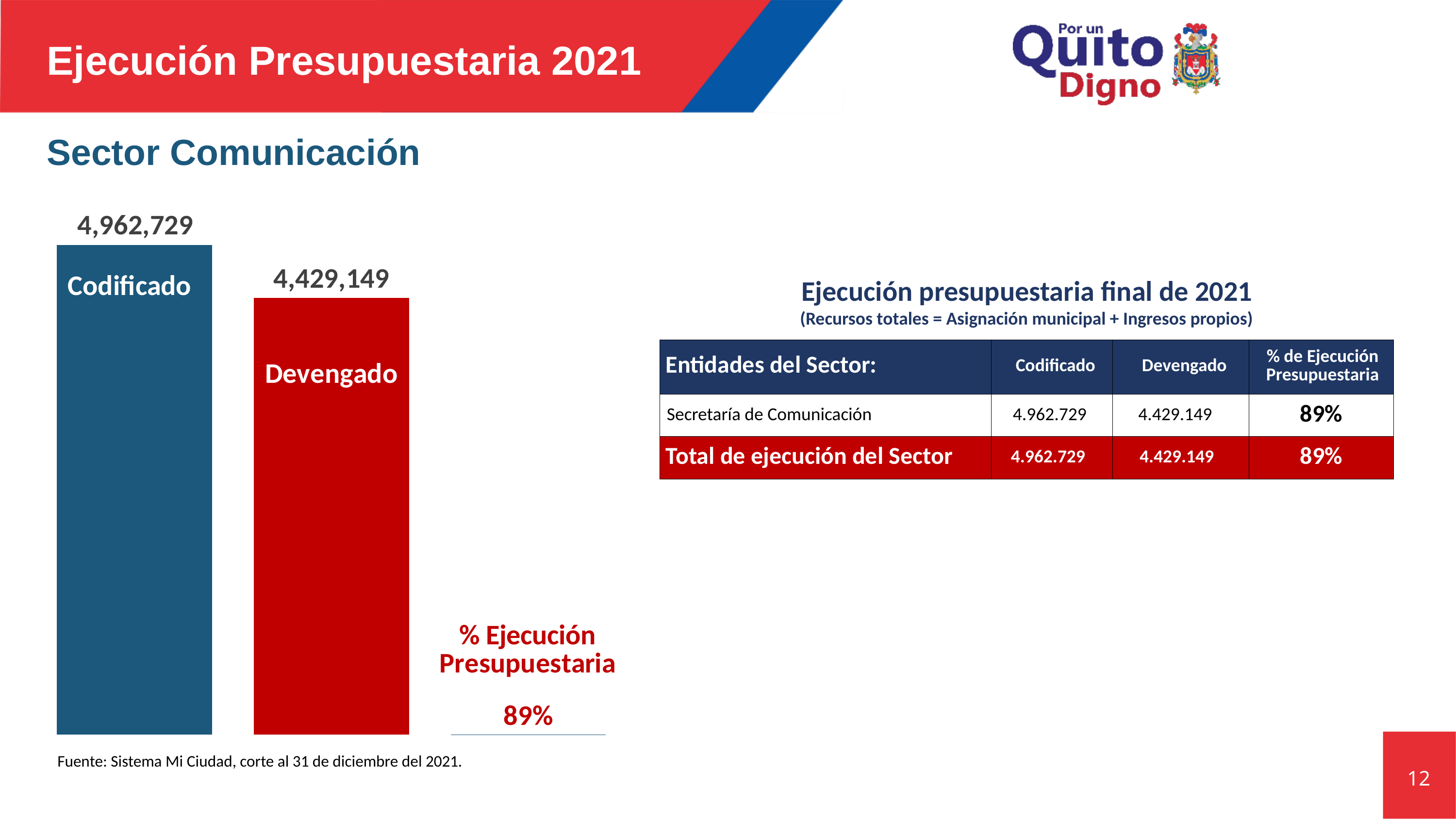
What colour is the Codificado bar in the chart? Blue What colour is the Devengado bar in the chart? Red Which bar in the chart is the lowest? Devengado Which is larger in the chart, Codificado or Devengado? Codificado What is the difference between the Codificado and Devengado values in the chart? 533,580 Do the bar values fall or rise from Codificado to Devengado in the chart? Fall What is the value of the Devengado bar in the chart? 4,429,149 What percentage is shown as the % Ejecución Presupuestaria next to the chart? 89% What is the value of the Codificado bar in the chart? 4,962,729 How many bars are plotted in the chart? 2 Which bar in the chart is the highest? Codificado What kind of chart is shown on the slide? Bar chart